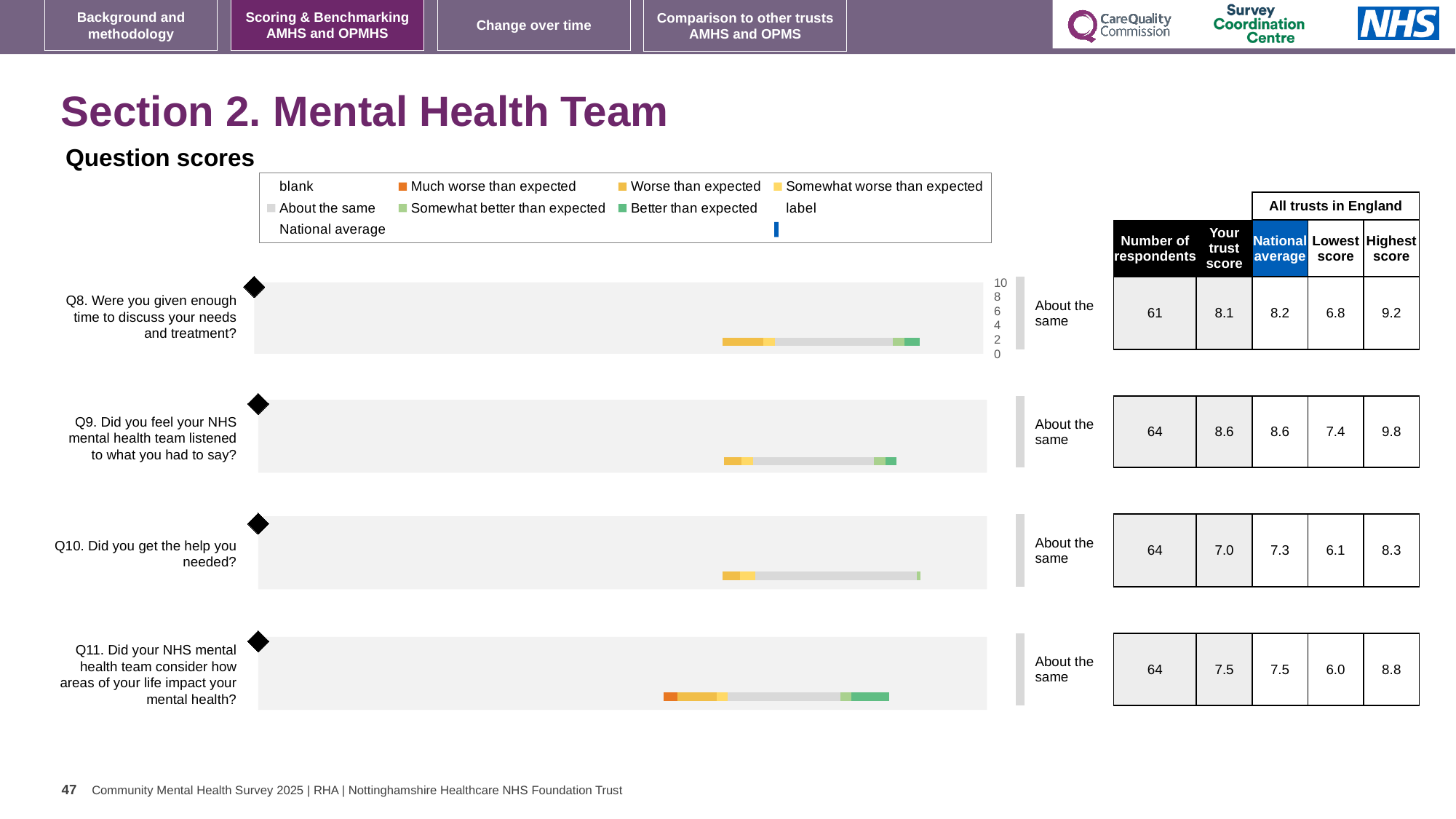
What is the difference between the national average and the trust score for Q10? 0.3 Which question has the lowest 'Your trust score'? Q10 Which question has the highest 'Your trust score'? Q9 What is the national average for Q10 (Did you get the help you needed)? 7.3 What is the highest score among all trusts in England for Q11? 8.8 How many respondents answered Q9? 64 What kind of chart is used to show the question scores for Q8 to Q11? bar chart What benchmark category is shown next to the Q10 chart? About the same Which is larger, the trust score for Q9 or the trust score for Q11? Q9 How many questions (Q8 to Q11) have a bar chart on this slide? 4 What is the 'Your trust score' value for Q8 (Were you given enough time to discuss your needs and treatment)? 8.1 In the legend, which colour represents 'Much worse than expected'? orange